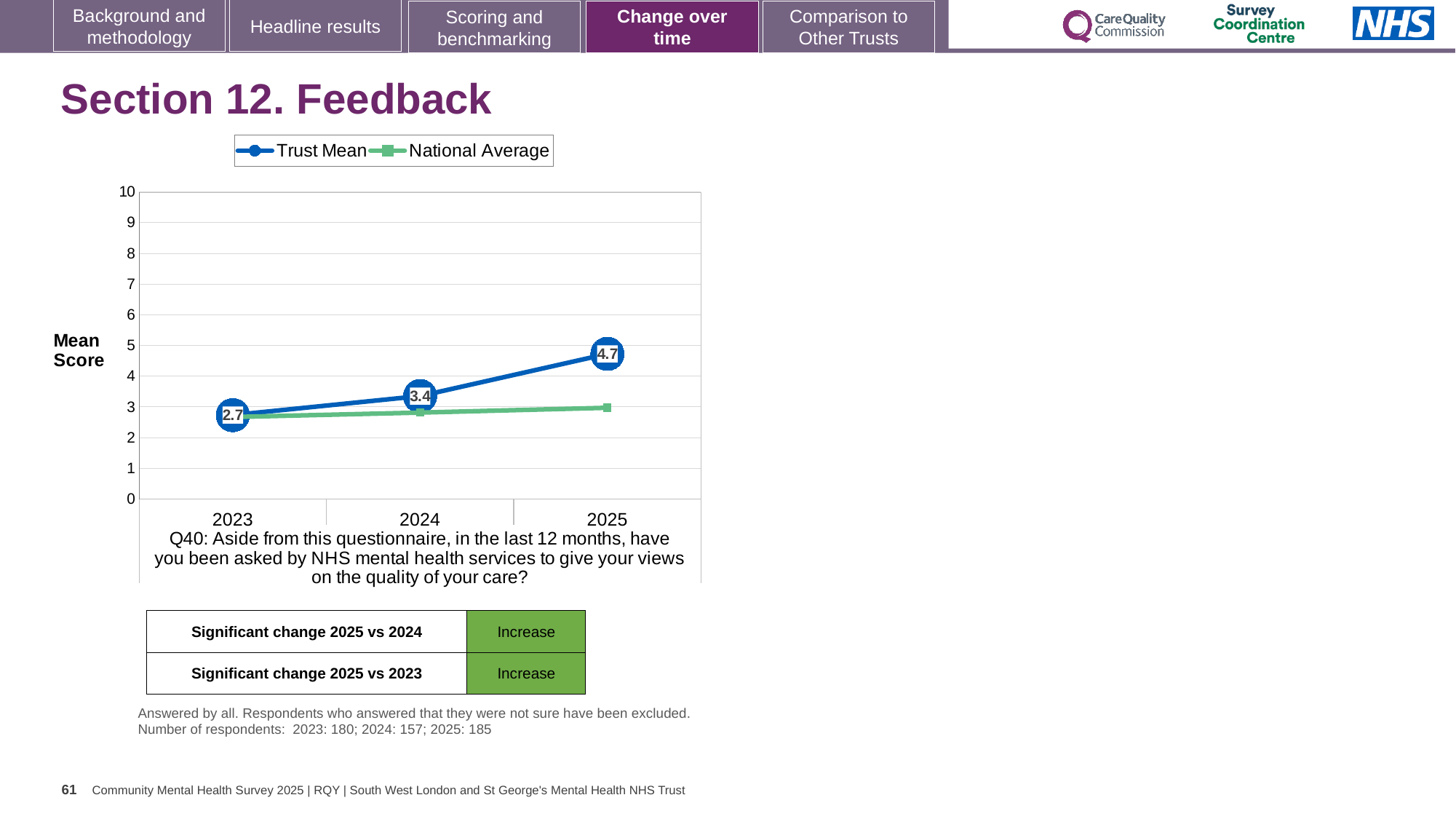
In which year is the Trust Mean lowest? 2023 How many years are shown on the x axis? 3 Is the National Average value for 2025 greater or less than 4? less What kind of chart is shown on the slide? line chart What is the Trust Mean value for 2025? 4.7 How many series does the legend list? 2 What is the Trust Mean value for 2024? 3.4 What is the difference between the Trust Mean in 2025 and in 2024? 1.3 What is the difference between the Trust Mean in 2025 and in 2023? 2.0 In which year is the Trust Mean highest? 2025 In 2025, which is larger, the Trust Mean or the National Average? Trust Mean What is the Trust Mean value for 2023? 2.7